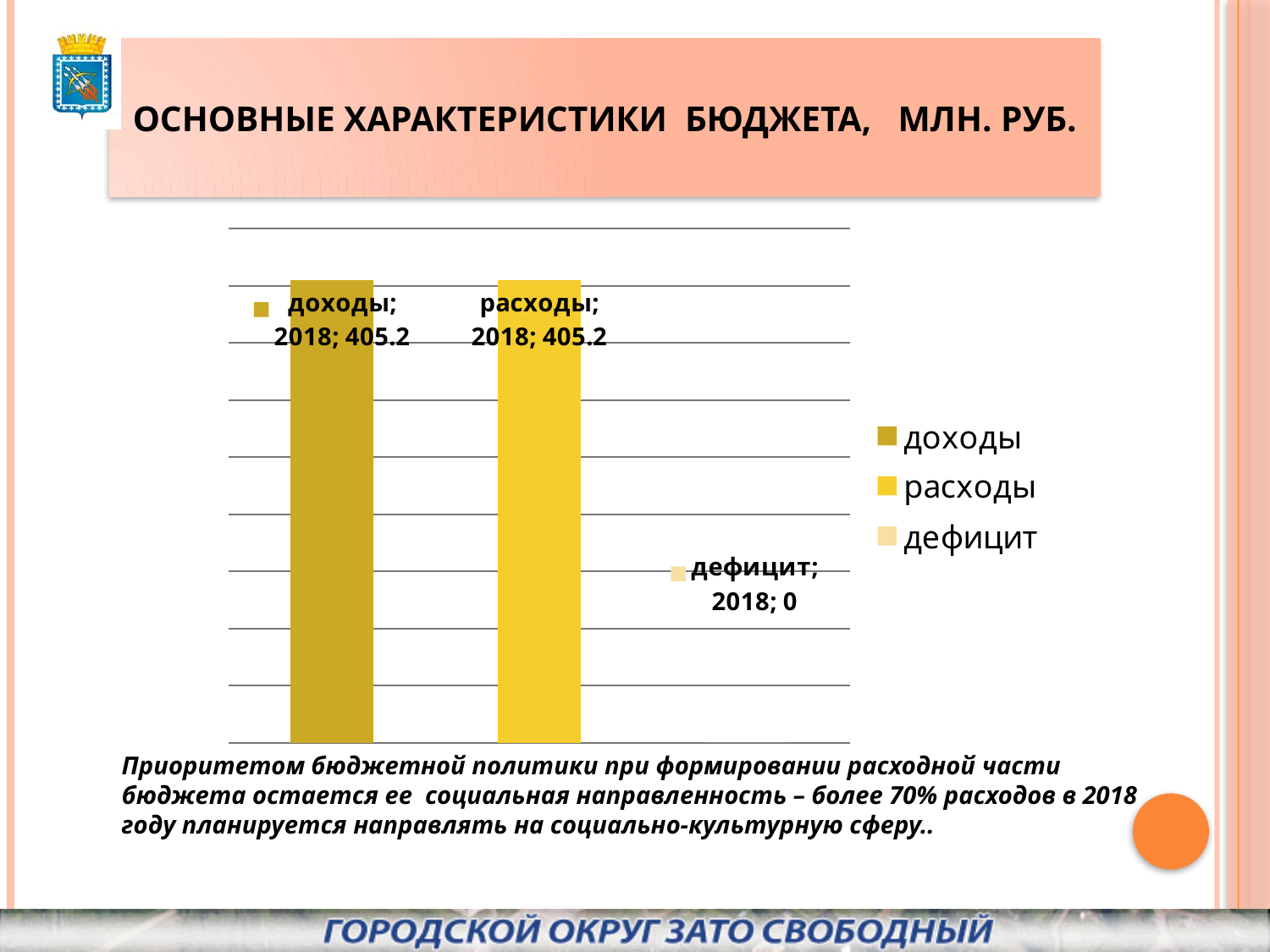
What is the value for дефицит in 2018? 0 What is the difference between доходы and расходы in 2018? 0 What kind of chart is shown on the slide? bar chart How many bars with a non-zero height are visible on the chart? 2 Which is larger, the value for расходы or the value for дефицит? расходы Which series has the lowest value on the chart? дефицит What is the difference between доходы and дефицит in 2018? 405.2 What is the value for расходы in 2018? 405.2 What year do the data labels on the chart refer to? 2018 What is the title of the slide above the chart? ОСНОВНЫЕ ХАРАКТЕРИСТИКИ БЮДЖЕТА, МЛН. РУБ. How many series does the legend list? 3 What is the value for доходы in 2018? 405.2